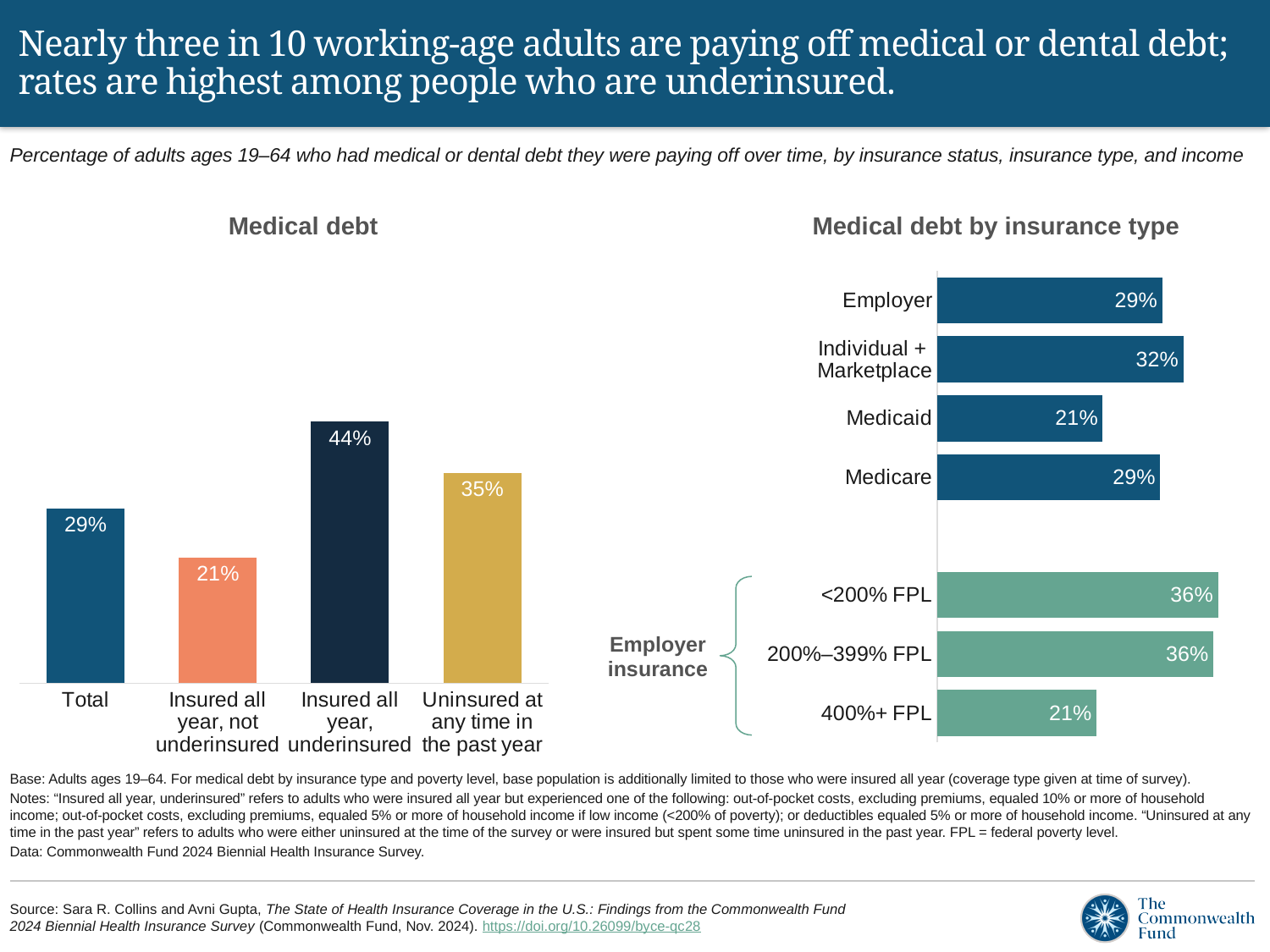
In the "Medical debt by insurance type" chart, which is larger, Employer or Individual + Marketplace? Individual + Marketplace In the "Medical debt by insurance type" chart, what is the value for 400%+ FPL among those with employer insurance? 21% In the "Medical debt" chart, what is the difference between Insured all year, underinsured and Uninsured at any time in the past year? 9 percentage points What kind of chart is the "Medical debt" chart? Bar chart In the "Medical debt" chart, what is the value for Total? 29% In the "Medical debt" chart, which category has the lowest value? Insured all year, not underinsured In the "Medical debt" chart, how many categories are shown? 4 In the "Medical debt by insurance type" chart, how many bars are shown in total? 7 In the "Medical debt by insurance type" chart, what is the difference between <200% FPL and 400%+ FPL? 15 percentage points In the "Medical debt" chart, what is the value for Insured all year, underinsured? 44% In the "Medical debt by insurance type" chart, what is the value for Medicaid? 21% In the "Medical debt by insurance type" chart, what is the value for Individual + Marketplace? 32%